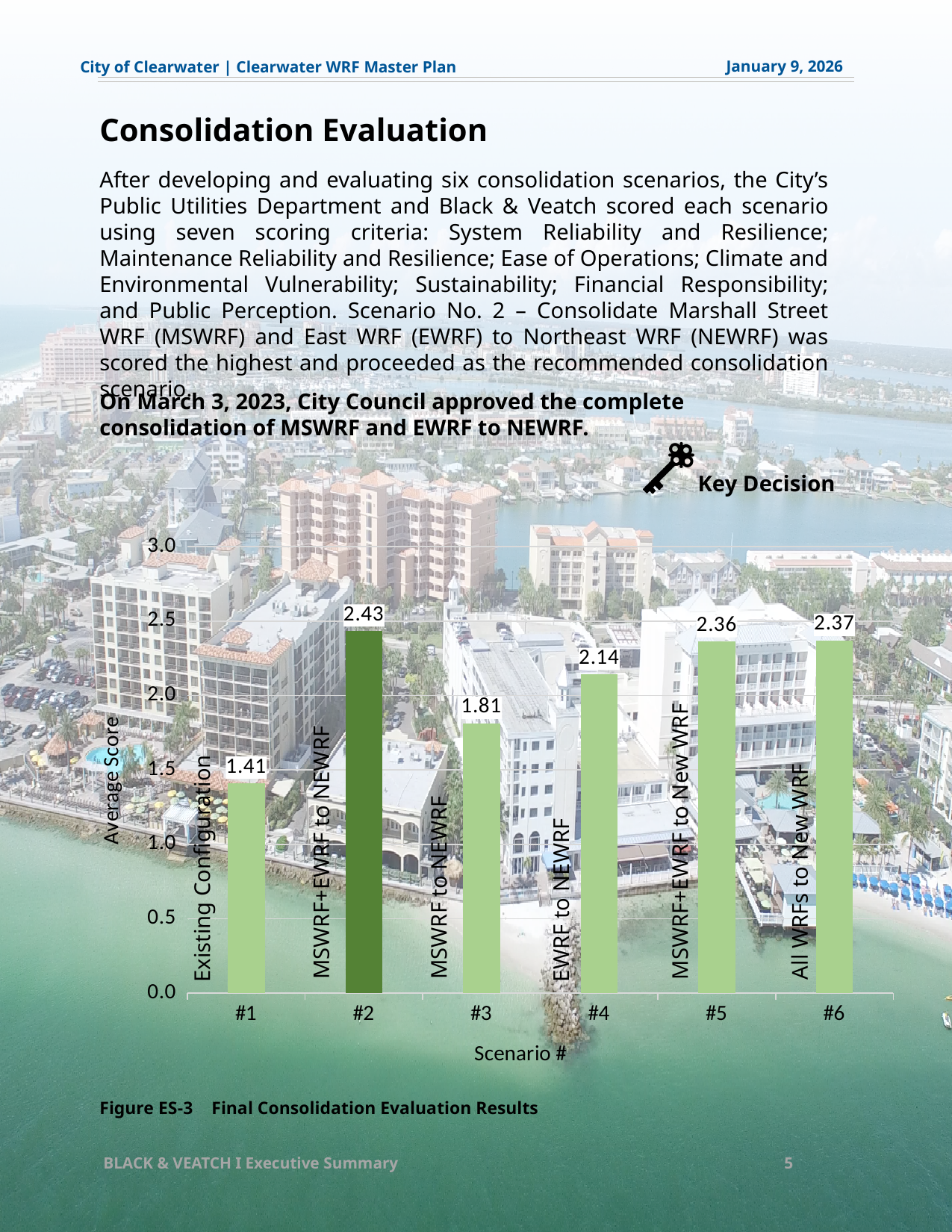
Which has a higher average score, Scenario #3 or Scenario #4? Scenario #4 Which scenario has the lowest average score? #1 What is the average score for Scenario #1 (Existing Configuration)? 1.41 Is the average score for Scenario #3 greater or less than 2.0? less What is the difference in average score between Scenario #2 and Scenario #1? 1.02 What is the label of the y axis of the chart? Average Score What is the average score for Scenario #4 (EWRF to NEWRF)? 2.14 What is the average score for Scenario #2? 2.43 How many scenarios are plotted in the chart? 6 What kind of chart is shown on the slide? bar chart What is the average score for Scenario #6 (All WRFs to New WRF)? 2.37 Which scenario has the highest average score? #2